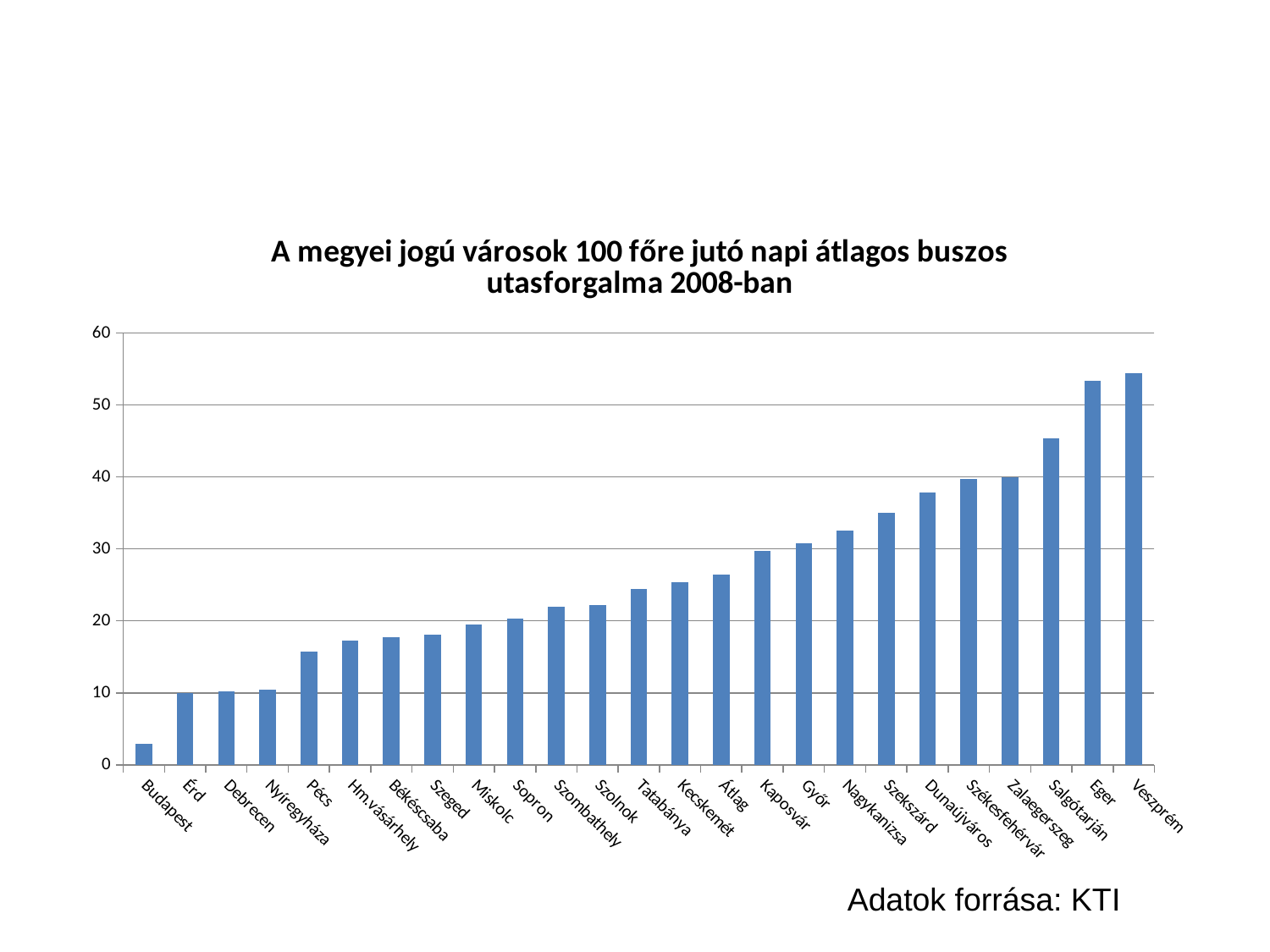
Do the values rise or fall from left to right along the x axis? rise Which category has the lowest value? Budapest Which category has the highest value? Veszprém Is the value for Eger greater or less than 50? greater What kind of chart is shown on the slide? bar chart Which has a larger value, Eger or Salgótarján? Eger Is the value for Átlag greater or less than 30? less What is the data source stated on the slide? KTI Is the value for Budapest greater or less than 10? less How many cities/categories are plotted on the x axis? 25